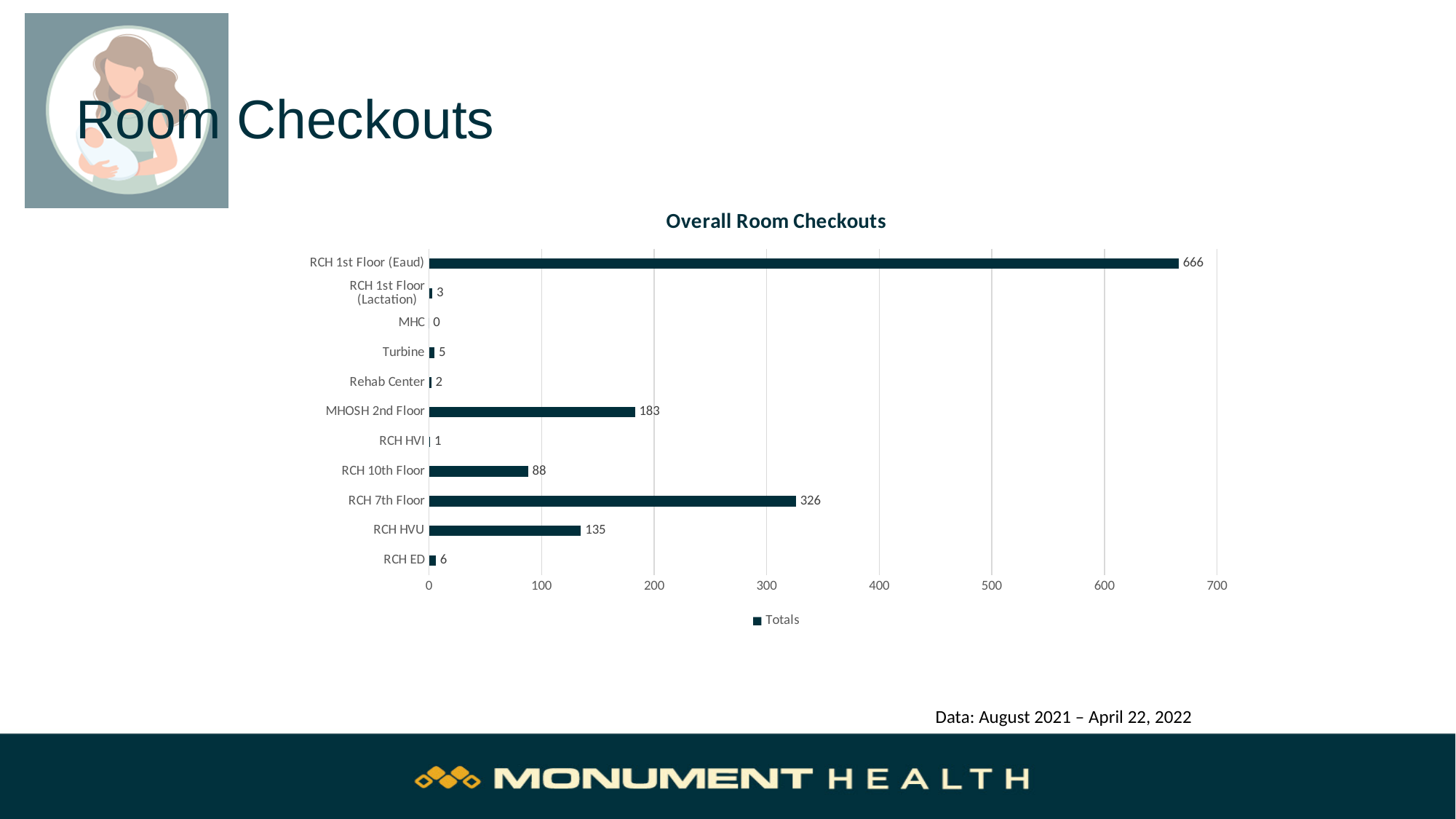
Which category has the highest value? RCH 1st Floor (Eaud) What is the value for RCH 7th Floor? 326 Which is larger, RCH HVU or MHOSH 2nd Floor? MHOSH 2nd Floor What is the title of the chart? Overall Room Checkouts What is the value for RCH 1st Floor (Eaud)? 666 How many series does the legend list? 1 What is the difference between RCH 7th Floor and RCH 10th Floor? 238 What is the value for RCH HVU? 135 How many categories are shown in the chart? 11 What is the value for MHOSH 2nd Floor? 183 Which category has the lowest value? MHC What kind of chart is shown? Bar chart